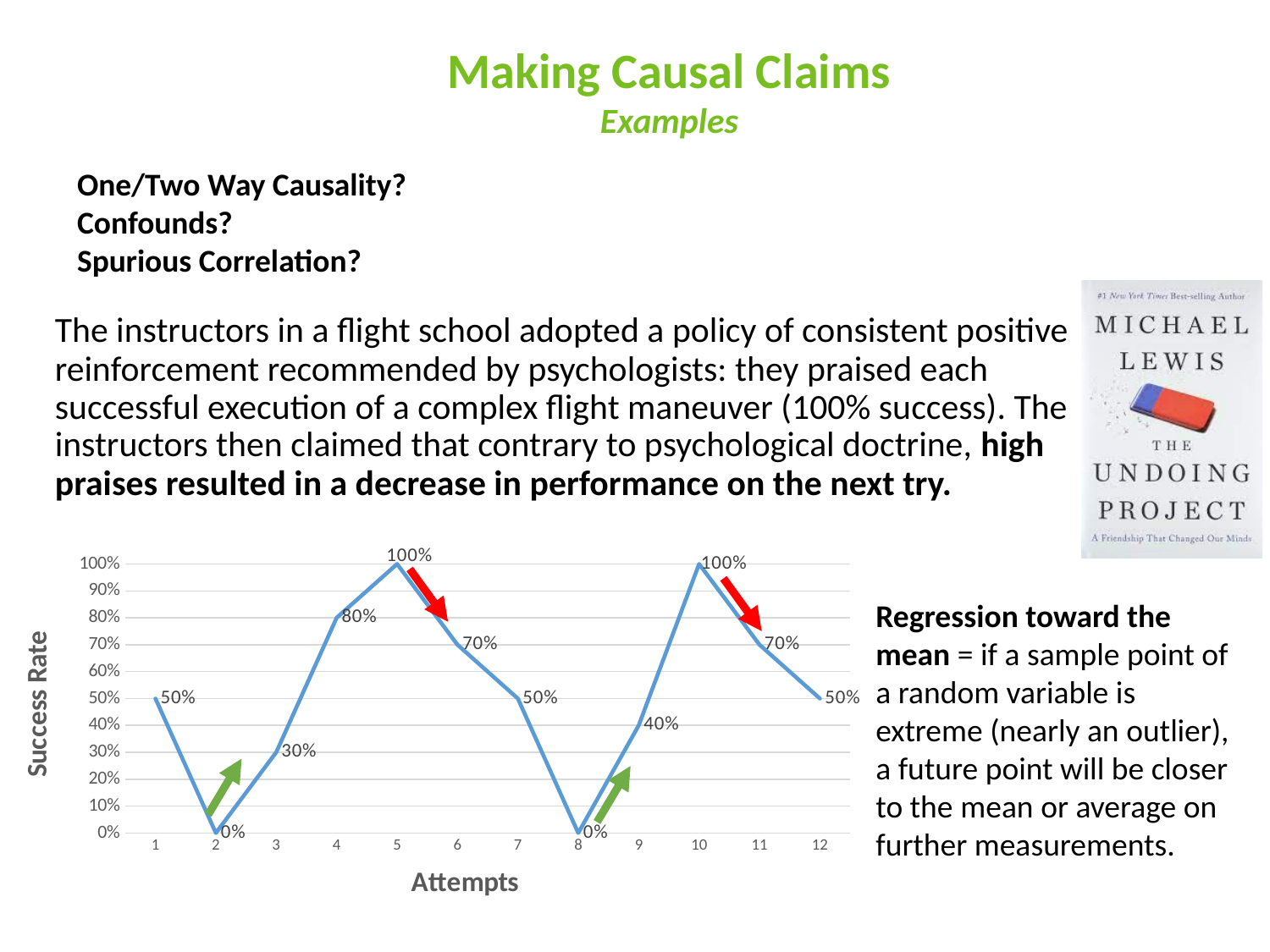
What is the difference between the success rate at attempt 4 and at attempt 3? 50% Does the success rate rise or fall from attempt 10 to attempt 12? fall Which attempts have the lowest success rate? 2 and 8 What type of chart is shown on the slide? line chart What is the success rate at attempt 4? 80% What is the success rate at attempt 3? 30% Which has a higher success rate, attempt 7 or attempt 9? attempt 7 What is the success rate at attempt 9? 40% What is the difference between the success rate at attempt 5 and at attempt 6? 30% Which attempts have the highest success rate? 5 and 10 What is the label of the y axis? Success Rate How many attempts are plotted on the x axis? 12